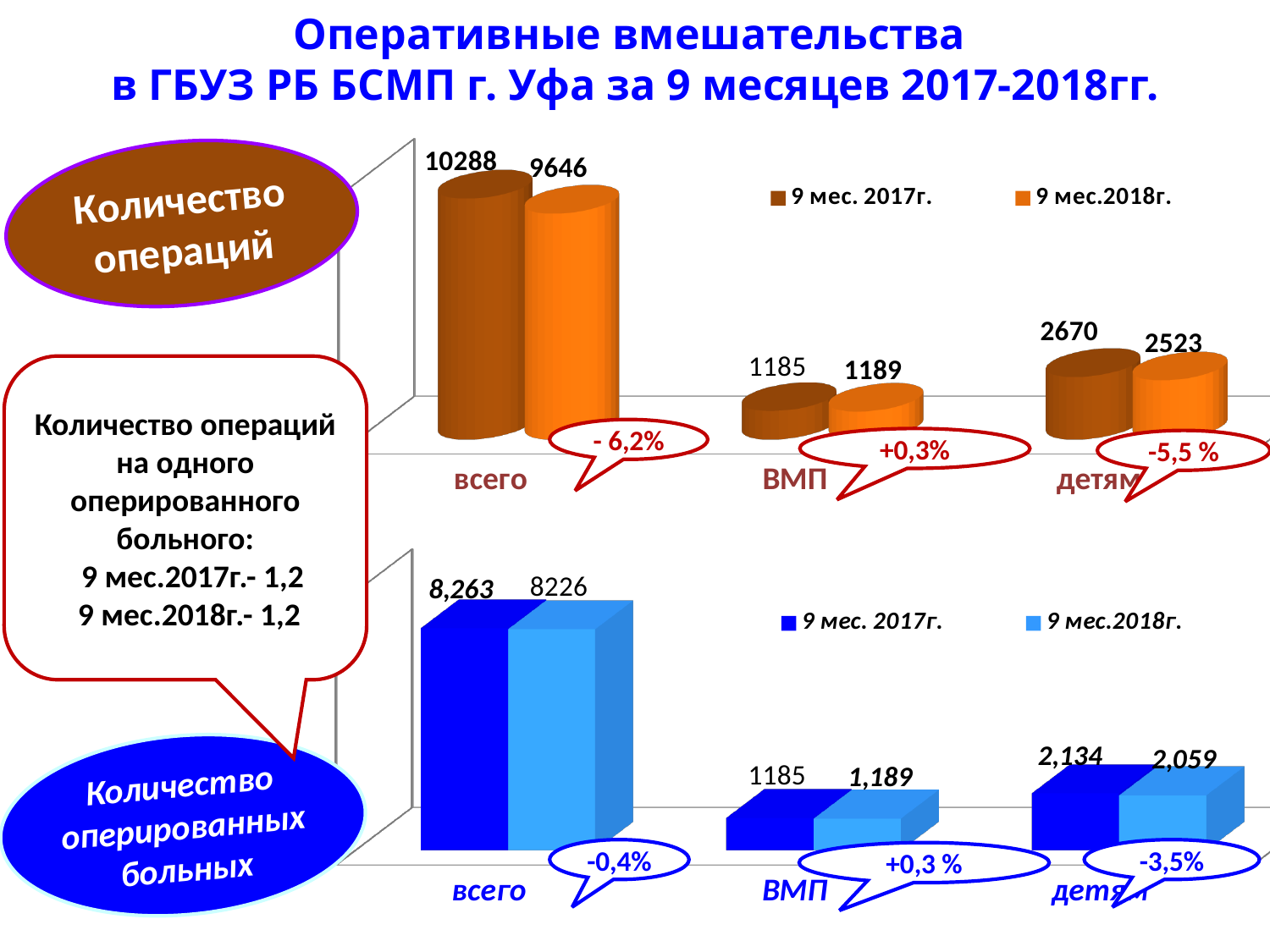
In the top chart (Количество операций), what is the value for детям for 9 мес.2018г.? 2523 In the top chart (Количество операций), which category has the highest value for 9 мес.2018г.? всего In the top chart (Количество операций), which category has the lowest value for 9 мес. 2017г.? ВМП In the bottom chart (Количество оперированных больных), what is the value for детям for 9 мес. 2017г.? 2,134 In the top chart (Количество операций), what is the difference between the 9 мес. 2017г. and 9 мес.2018г. values for всего? 642 In the top chart (Количество операций), what is the value for всего for 9 мес. 2017г.? 10288 In the bottom chart (Количество оперированных больных), what colour represents 9 мес.2018г.? light blue In the top chart (Количество операций), how many series does the legend list? 2 In the bottom chart (Количество оперированных больных), which is larger for детям: 9 мес. 2017г. or 9 мес.2018г.? 9 мес. 2017г. In the bottom chart (Количество оперированных больных), what is the value for всего for 9 мес.2018г.? 8226 What kind of chart is the bottom chart (Количество оперированных больных)? bar chart In the bottom chart (Количество оперированных больных), how many categories are shown on the x axis? 3